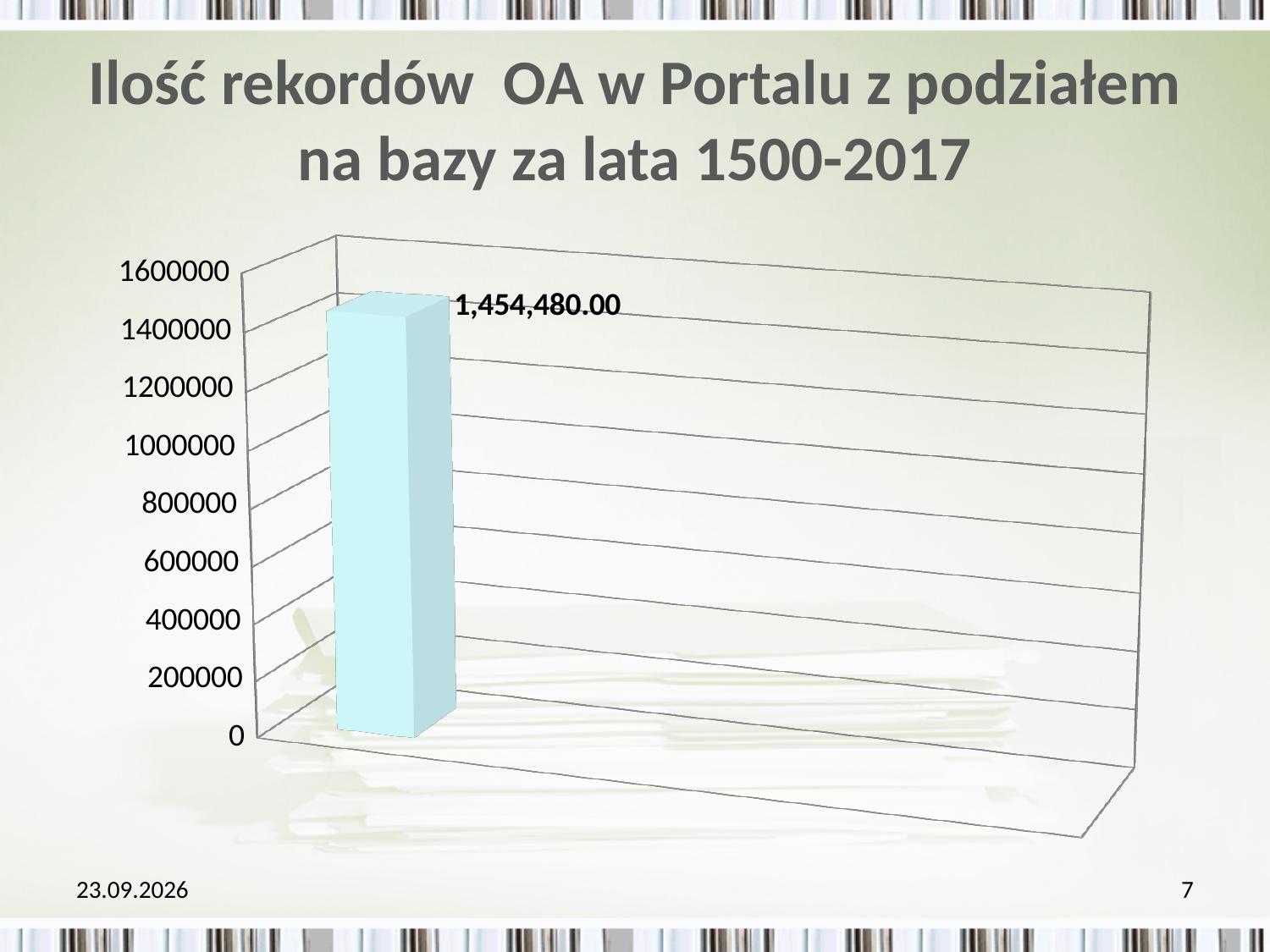
What is the title of the slide containing the chart? Ilość rekordów OA w Portalu z podziałem na bazy za lata 1500-2017 What is the highest tick value shown on the vertical axis of the chart? 1600000 What kind of chart is shown on the slide? bar chart How many bars are plotted in the chart? 1 What value is printed as the data label on the single bar in the chart? 1,454,480.00 Is the value of the bar in the chart greater or less than 1600000? less Is the value of the bar in the chart greater or less than 1000000? greater